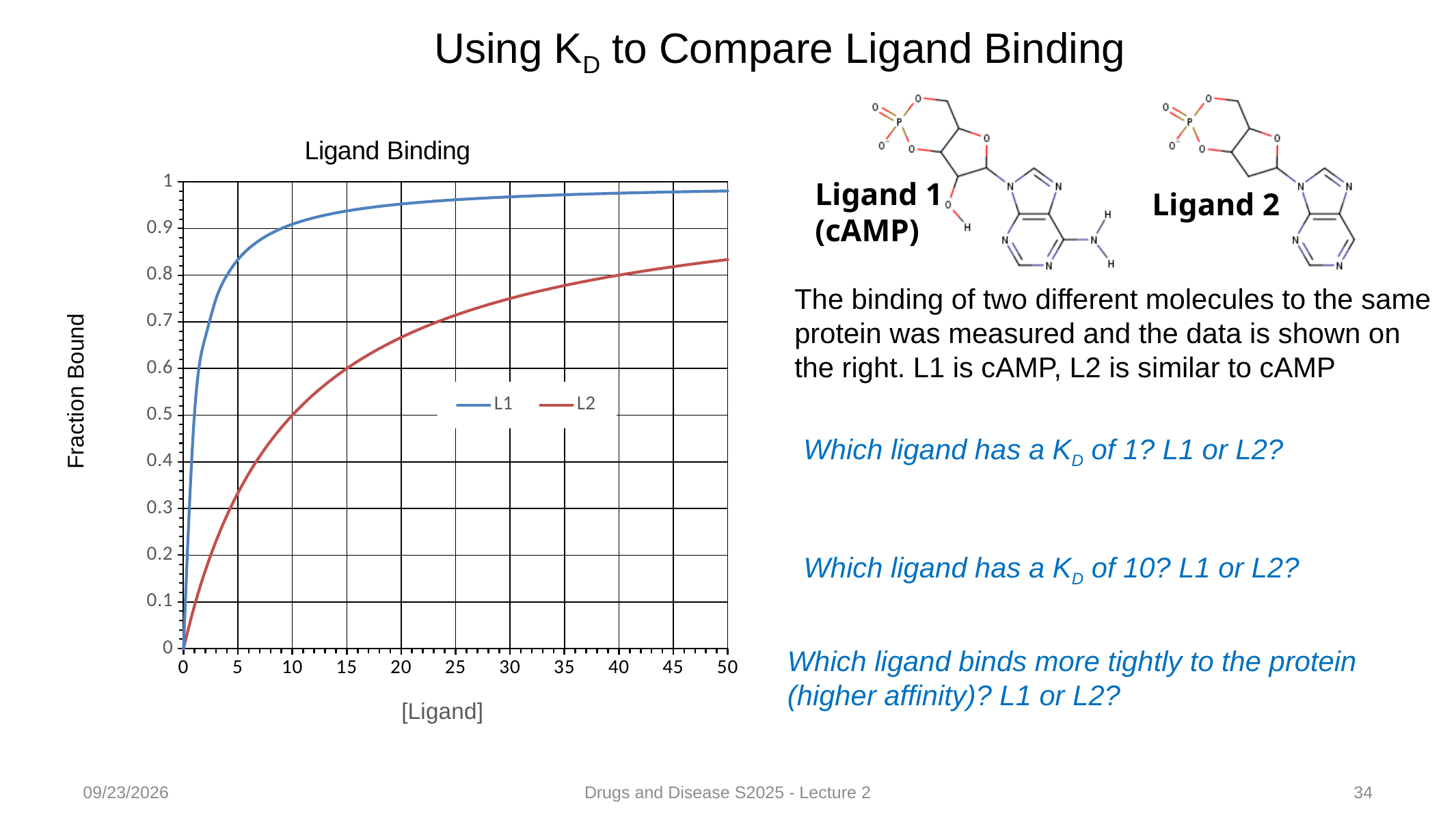
Which series reaches a higher fraction bound at a [Ligand] value of 50, L1 or L2? L1 How many series does the legend of the Ligand Binding chart list? 2 Is the fraction bound for L2 at a [Ligand] value of 30 greater or less than 0.8? less Is the fraction bound for L2 at a [Ligand] value of 20 greater or less than 0.6? greater What is the label of the y axis of the chart? Fraction Bound Is the fraction bound for L1 at a [Ligand] value of 20 greater or less than 0.9? greater Does the fraction bound for L2 rise or fall as [Ligand] increases? rise What kind of chart is shown on the slide? line chart What is the title of the chart? Ligand Binding Which series is higher at a [Ligand] value of 20, L1 or L2? L1